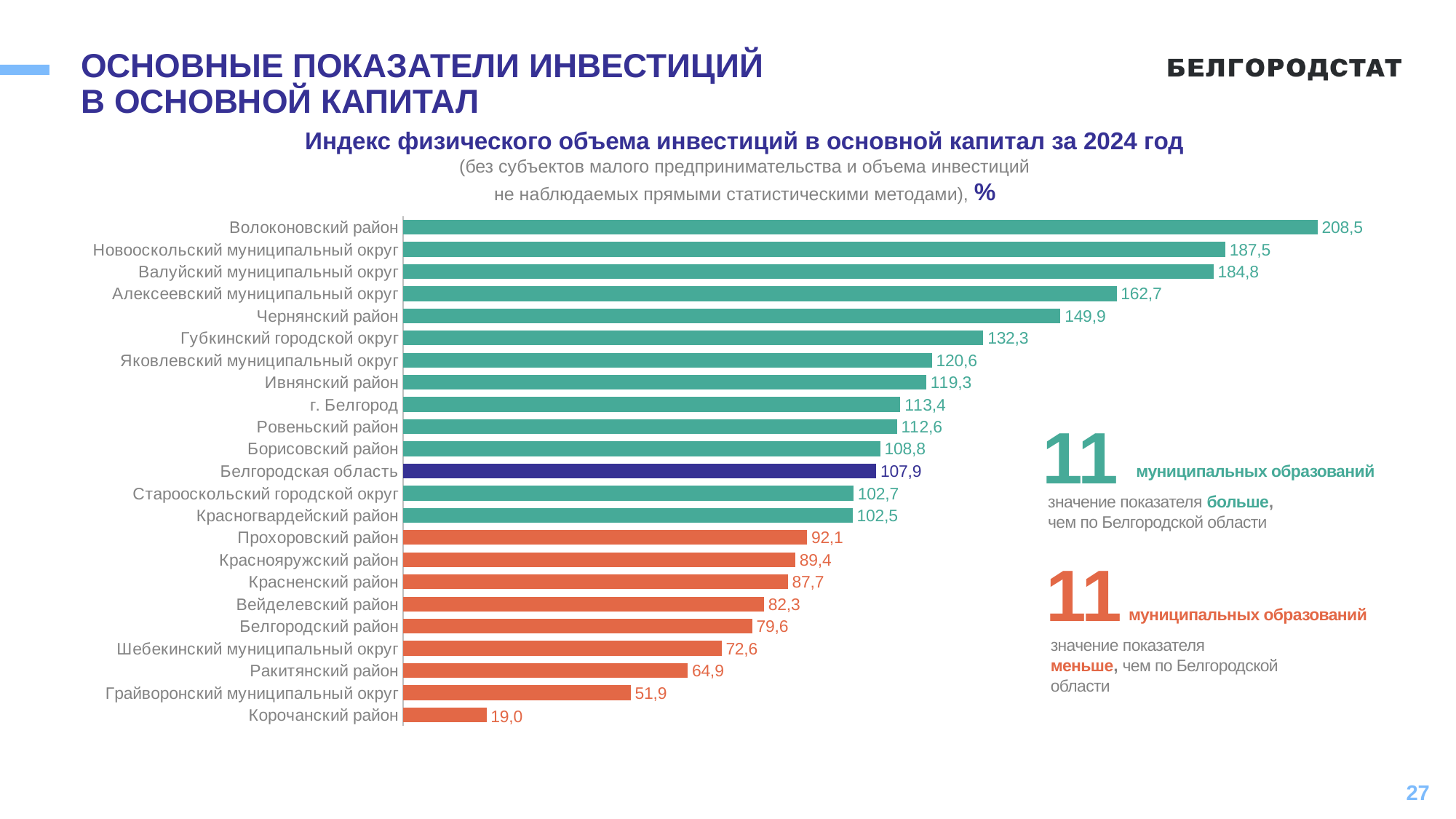
What kind of chart is shown on the slide? Bar chart What is the difference between the value for Белгородская область and the value for Корочанский район? 88,9 What is the difference between the values for Новооскольский муниципальный округ and Валуйский муниципальный округ? 2,7 How many bars are plotted in the chart? 23 What is the value for Волоконовский район? 208,5 According to the slide, how many municipalities have a value greater than the Belgorod region value? 11 Which category has the lowest value? Корочанский район What is the value for Белгородская область? 107,9 What is the value for Шебекинский муниципальный округ? 72,6 What colour is the bar for Белгородская область? Dark blue Which is larger, the value for Губкинский городской округ or the value for Чернянский район? Чернянский район Which category has the highest value? Волоконовский район